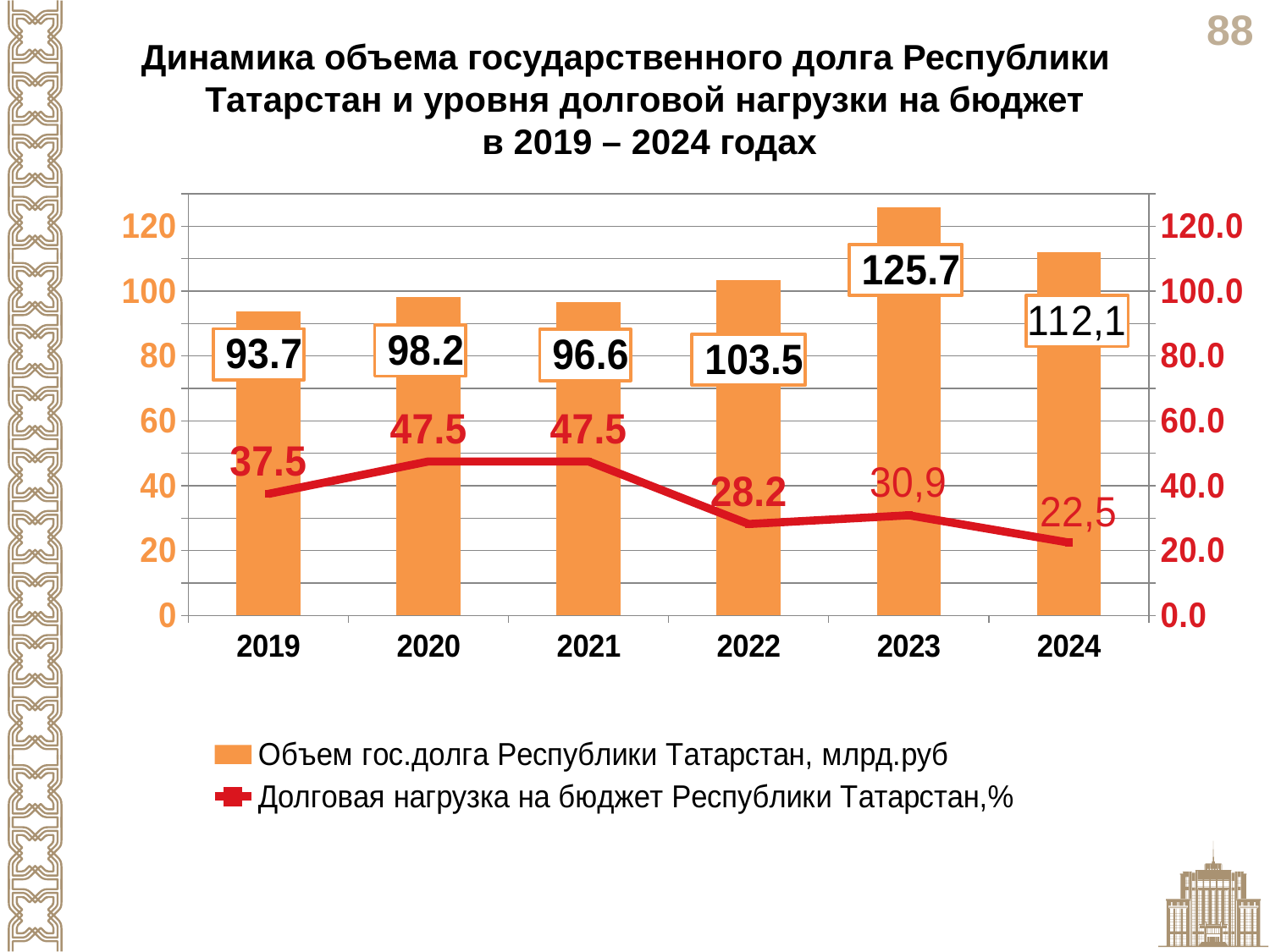
What is the difference between the state debt volume in 2023 and in 2022, in billion rubles? 22.2 What is the debt burden on the budget shown for 2024? 22,5 What kinds of chart are combined on this slide? A bar chart and a line chart What is the debt burden on the budget of the Republic of Tatarstan in 2020, in %? 47.5 What is the volume of state debt of the Republic of Tatarstan in 2023, in billion rubles? 125.7 What is the volume of state debt shown for 2024? 112,1 In which year is the volume of state debt the highest? 2023 How many years are shown on the x axis? 6 How many series does the legend list? 2 Which year has a larger state debt volume, 2020 or 2021? 2020 In which year is the debt burden on the budget the lowest? 2024 Does the debt burden on the budget rise or fall from 2021 to 2022? Fall